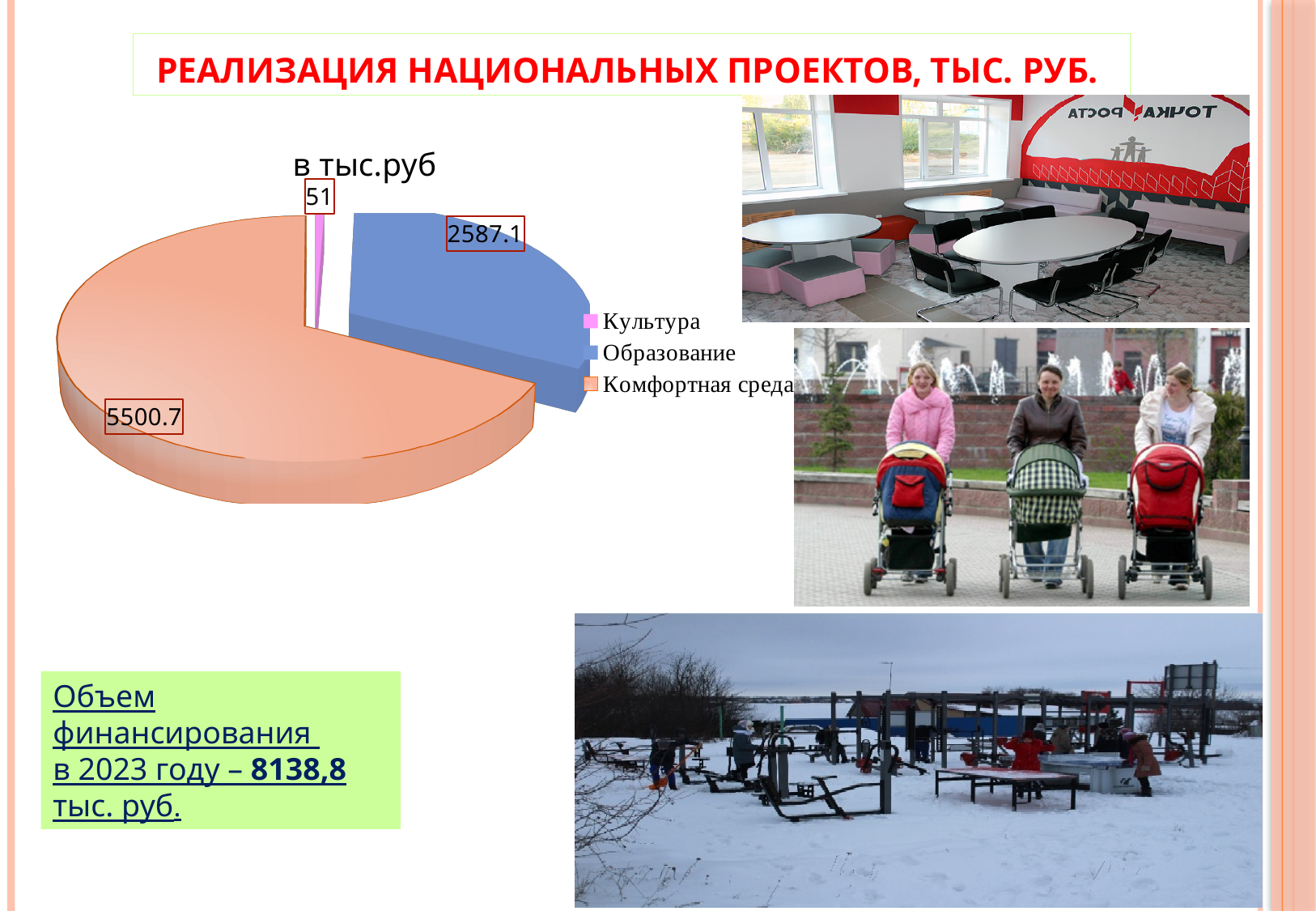
How many categories does the pie chart show? 3 Which category has the largest slice in the pie chart? Комфортная среда What type of chart is shown on the slide? pie chart What is the value for Образование in the pie chart? 2587.1 What is the value for Комфортная среда in the pie chart? 5500.7 What is the difference between the values for Комфортная среда and Образование? 2913.6 What is the difference between the values for Образование and Культура? 2536.1 What is the total of all slices in the pie chart? 8138.8 What is the title of the pie chart? в тыс.руб Which is larger, the value for Образование or the value for Культура? Образование What is the value for Культура in the pie chart? 51 Which category has the smallest slice in the pie chart? Культура